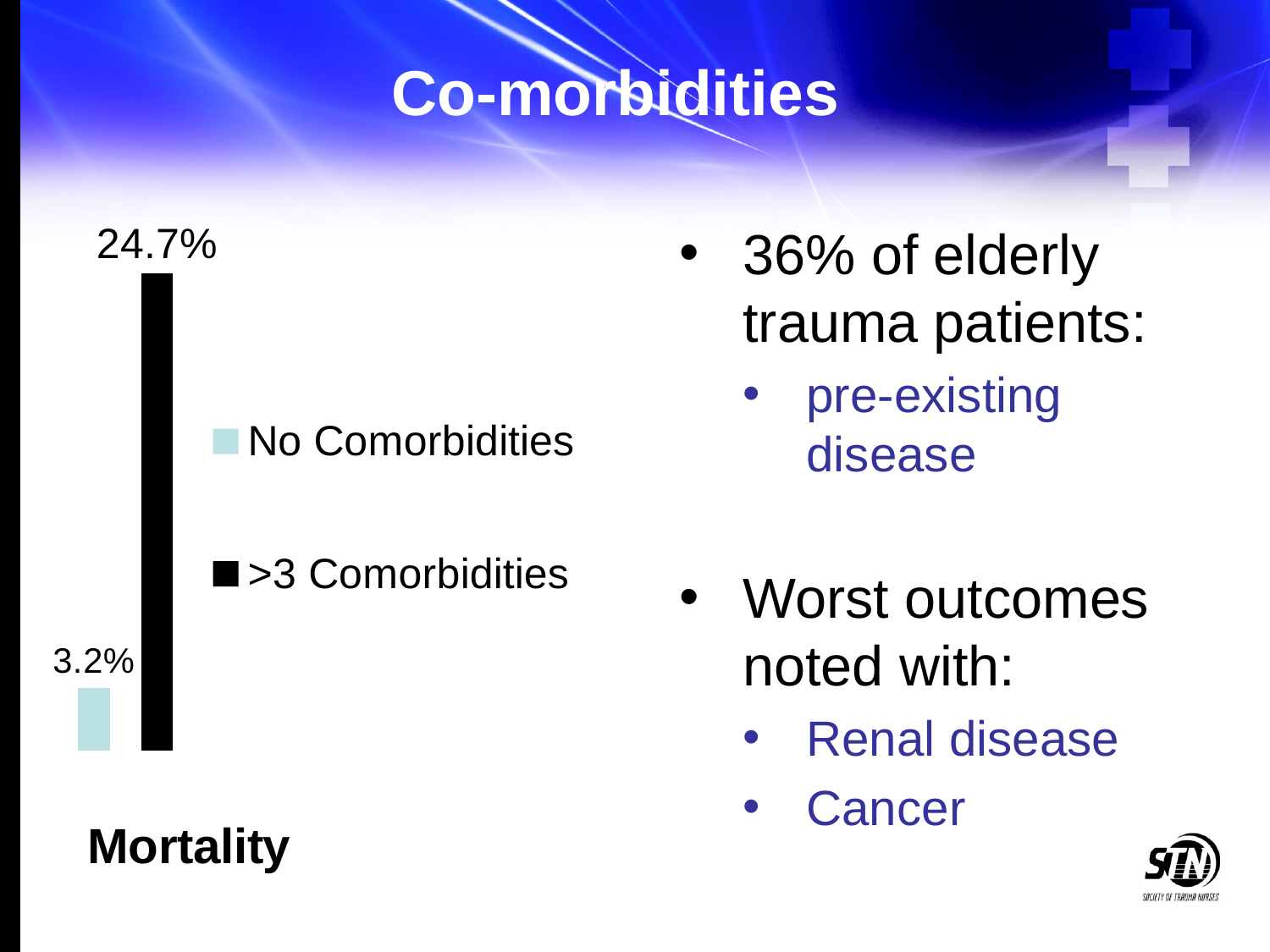
What is the mortality value for >3 Comorbidities? 24.7% What is the label shown beneath the chart? Mortality How many series does the legend list? 2 What colour is the bar for >3 Comorbidities? Black What is the mortality value for No Comorbidities? 3.2% What kind of chart is shown on the slide? Bar chart Which series has the lowest mortality value? No Comorbidities Which series has the highest mortality value? >3 Comorbidities How many bars are plotted in the chart? 2 Which series has the higher mortality, No Comorbidities or >3 Comorbidities? >3 Comorbidities What is the difference in mortality between >3 Comorbidities and No Comorbidities? 21.5%